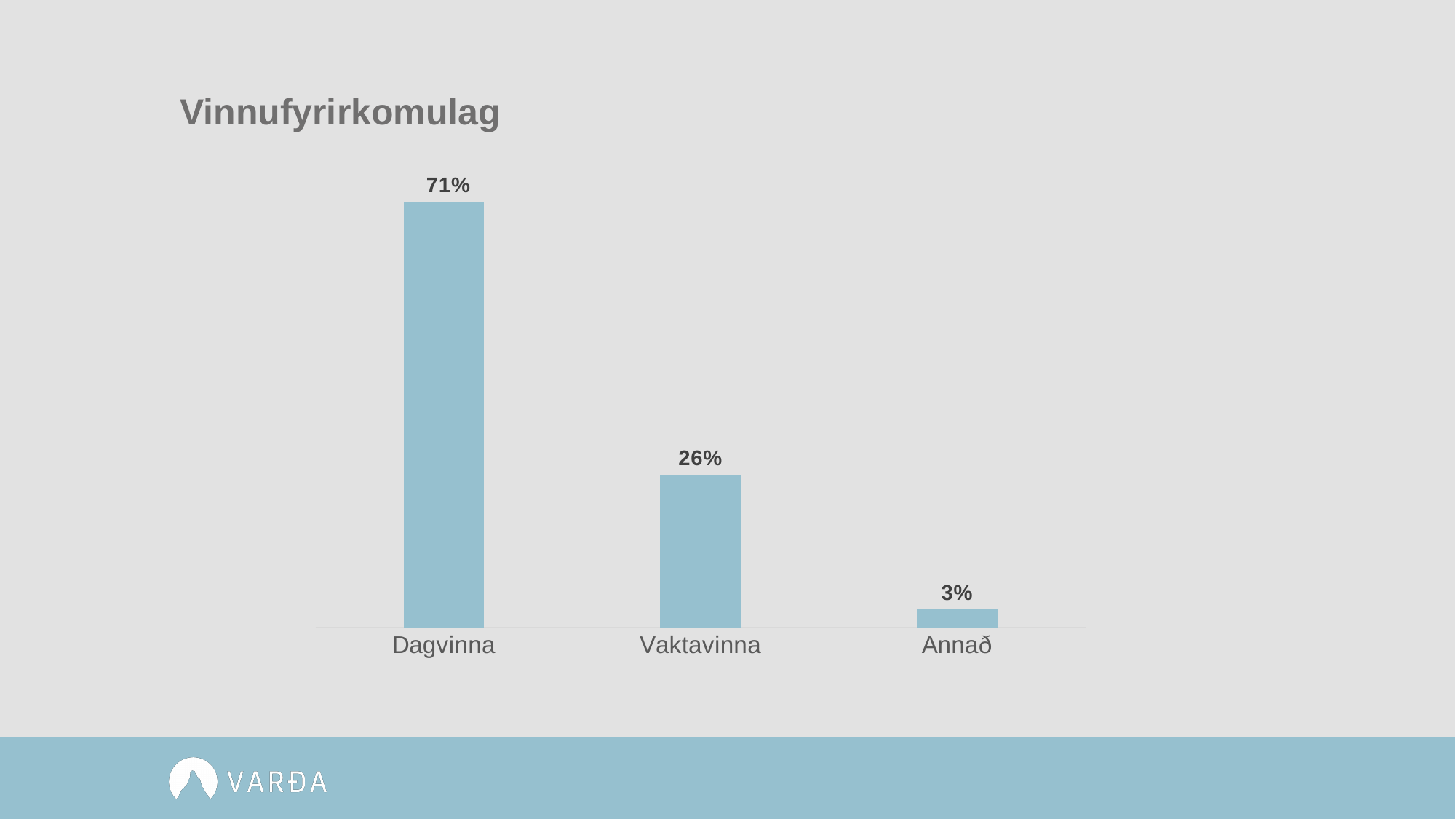
What is the title of the chart? Vinnufyrirkomulag How many categories are shown in the chart? 3 What is the difference between the values for Dagvinna and Vaktavinna? 45% Which category has the lowest value? Annað What kind of chart is shown on the slide? Bar chart What is the value for Annað? 3% Which category has the highest value? Dagvinna What is the value for Vaktavinna? 26% What is the difference between the values for Vaktavinna and Annað? 23% Which is larger, the value for Vaktavinna or the value for Annað? Vaktavinna What is the value for Dagvinna? 71% Do the values rise or fall from left to right along the x axis? Fall